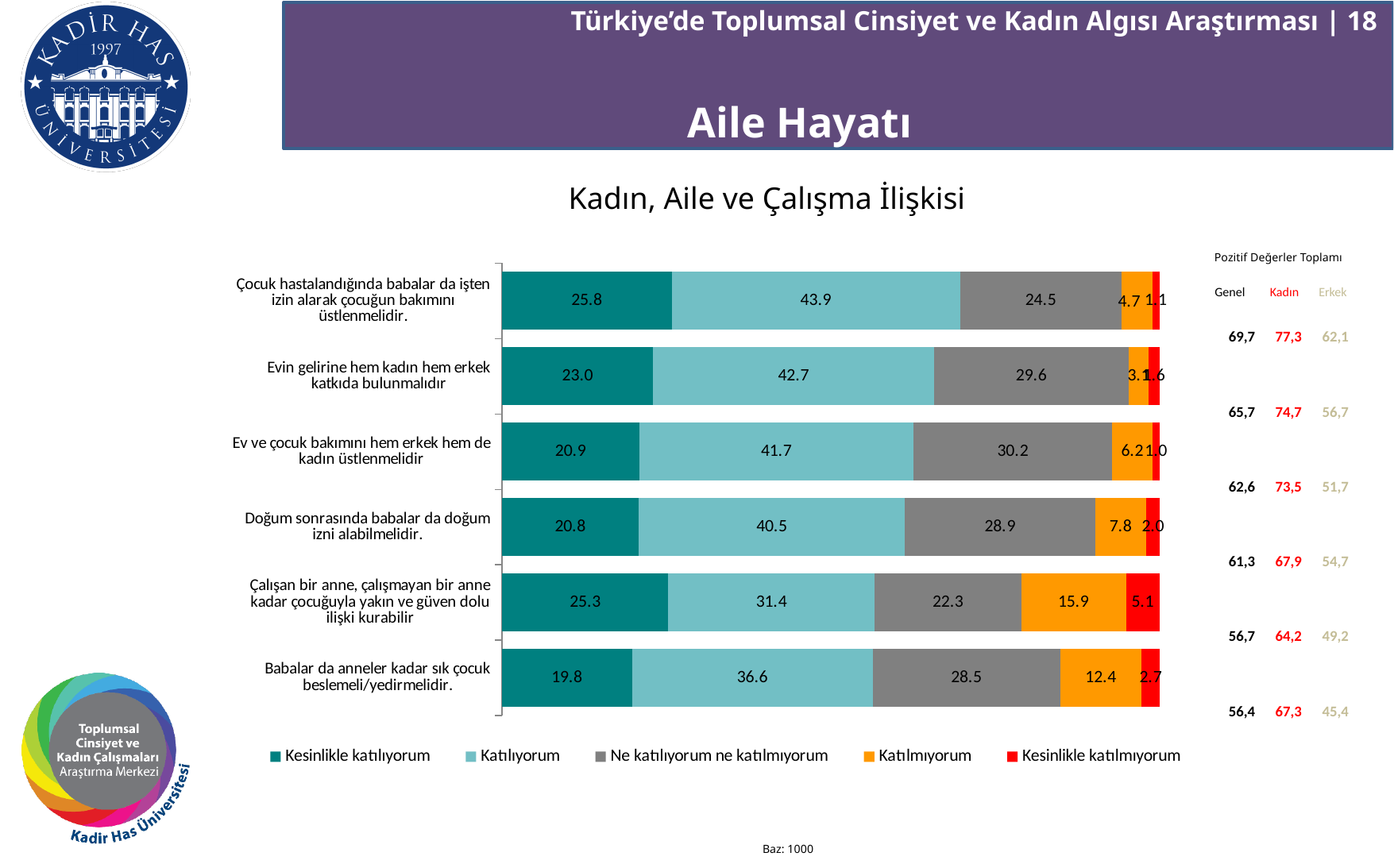
What is the 'Kesinlikle katılıyorum' value for 'Çocuk hastalandığında babalar da işten izin alarak çocuğun bakımını üstlenmelidir.'? 25.8 How many statements (categories) are plotted in the chart? 6 Which statement has the lowest 'Kesinlikle katılıyorum' value? Babalar da anneler kadar sık çocuk beslemeli/yedirmelidir. What is the 'Ne katılıyorum ne katılmıyorum' value for 'Ev ve çocuk bakımını hem erkek hem de kadın üstlenmelidir'? 30.2 What is the 'Katılıyorum' value for 'Evin gelirine hem kadın hem erkek katkıda bulunmalıdır'? 42.7 What kind of chart is shown on the slide? Stacked bar chart Which has the larger 'Ne katılıyorum ne katılmıyorum' value: 'Ev ve çocuk bakımını hem erkek hem de kadın üstlenmelidir' or 'Doğum sonrasında babalar da doğum izni alabilmelidir.'? Ev ve çocuk bakımını hem erkek hem de kadın üstlenmelidir Which statement has the highest 'Katılıyorum' value? Çocuk hastalandığında babalar da işten izin alarak çocuğun bakımını üstlenmelidir. What is the 'Katılmıyorum' value for 'Çalışan bir anne, çalışmayan bir anne kadar çocuğuyla yakın ve güven dolu ilişki kurabilir'? 15.9 How many series does the legend list? 5 What is the difference between the 'Katılıyorum' values for 'Çocuk hastalandığında babalar da işten izin alarak çocuğun bakımını üstlenmelidir.' and 'Babalar da anneler kadar sık çocuk beslemeli/yedirmelidir.'? 7.3 What is the title shown above the chart? Kadın, Aile ve Çalışma İlişkisi